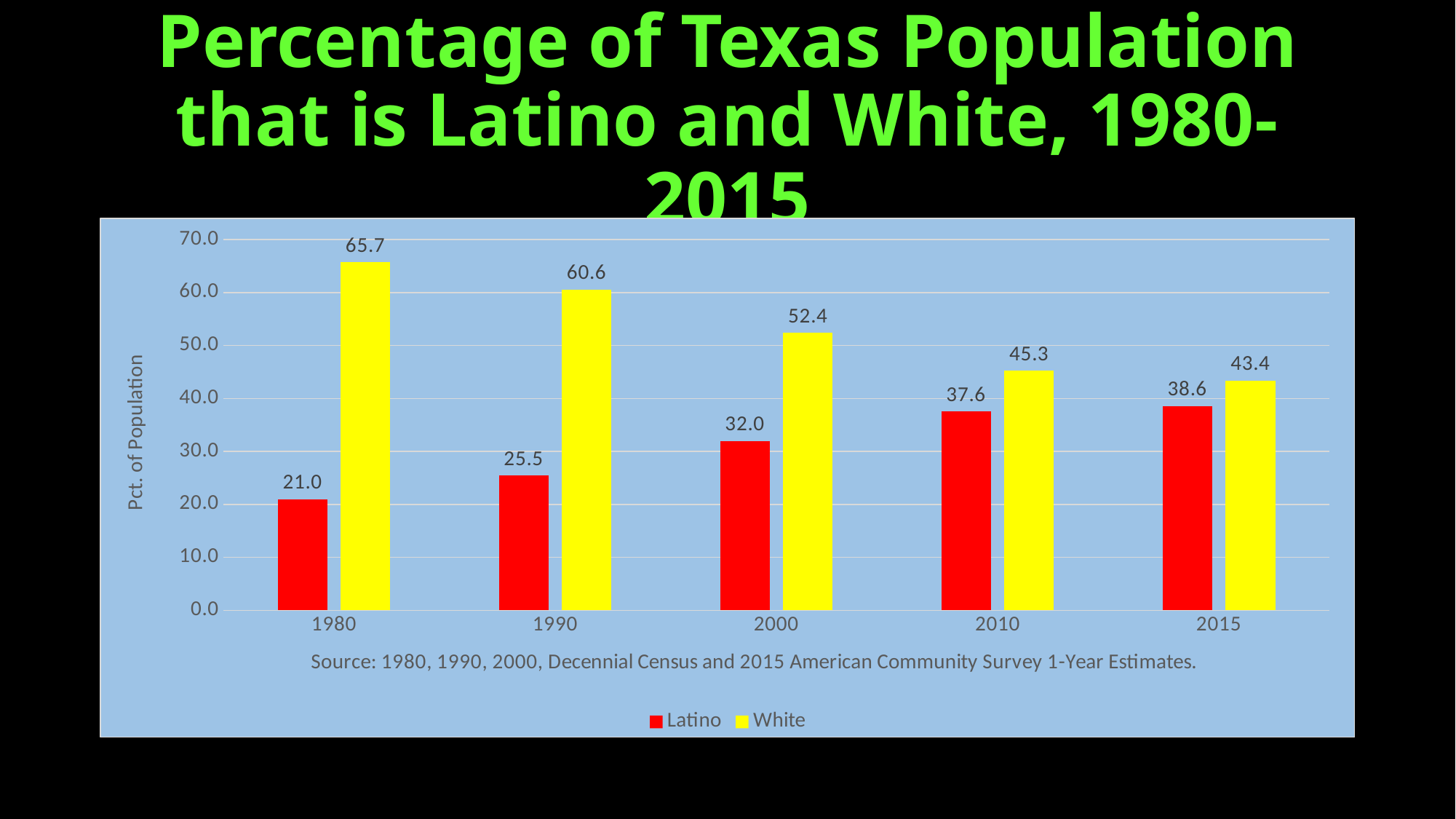
What is the difference between the White and Latino percentages in 2015? 4.8 In which year is the Latino percentage lowest? 1980 What kind of chart is shown on the slide? Bar chart Does the White percentage rise or fall from 1980 to 2015? Fall What is the difference between the White and Latino percentages in 1980? 44.7 What is the White percentage of the Texas population in 2000? 52.4 Which is larger in 2010, the Latino value or the White value? White What is the Latino value for 2015? 38.6 What is the Latino percentage of the Texas population in 1980? 21.0 How many series does the legend list? 2 How many years are shown on the x axis? 5 In which year is the White percentage highest? 1980